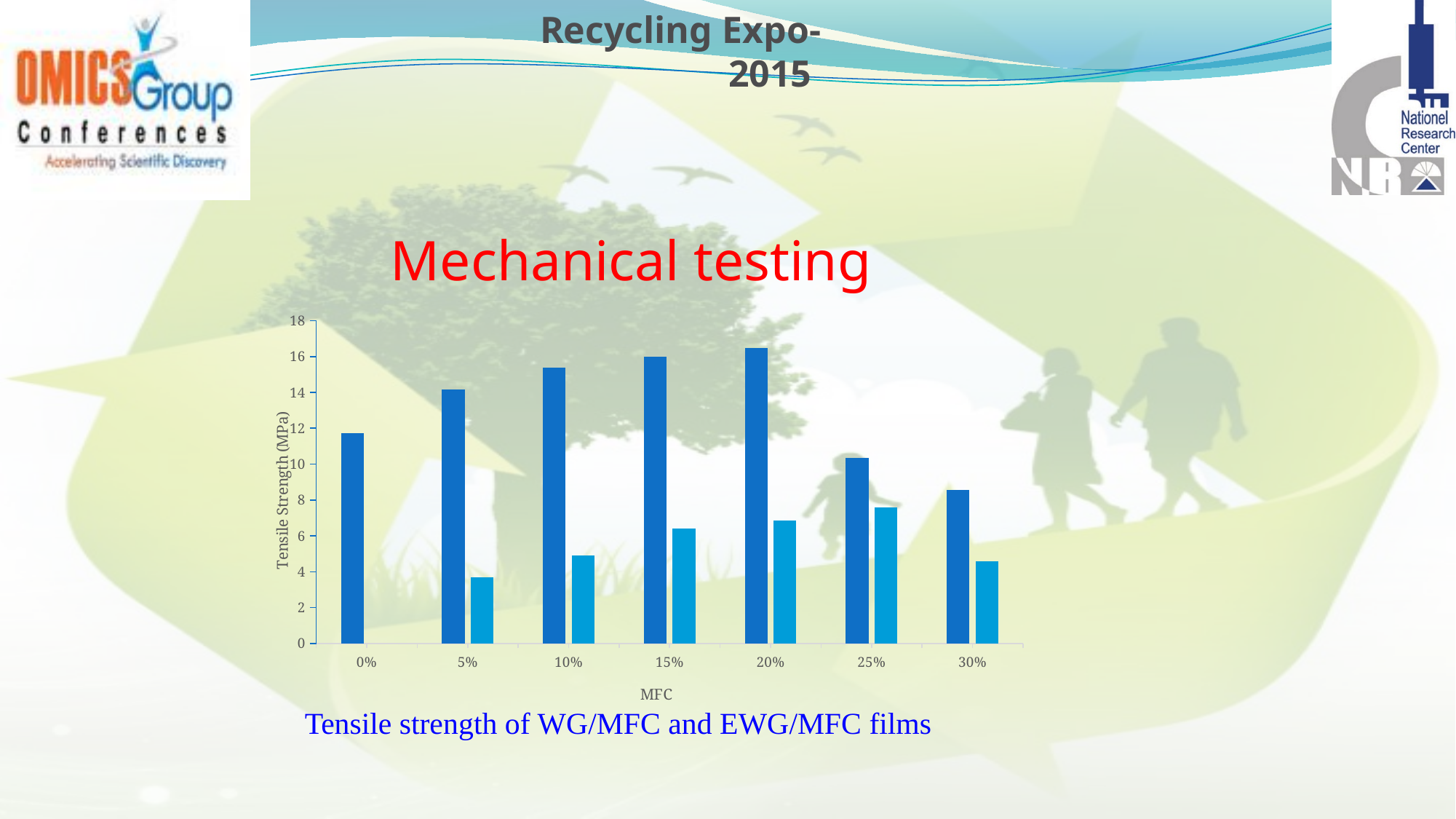
How many MFC categories are shown on the x axis of the chart? 7 Do the dark blue bars rise or fall from 0% MFC to 20% MFC? rise At which MFC level is the dark blue bar the lowest? 30% Is the light blue bar at 25% MFC greater or less than 6 MPa? greater What is the label on the y axis of the chart? Tensile Strength (MPa) At which MFC level is the light blue bar the highest? 25% Which has the taller dark blue bar, 10% MFC or 25% MFC? 10% Is the dark blue bar at 30% MFC greater or less than 10 MPa? less Is the dark blue bar at 0% MFC greater or less than 10 MPa? greater At which MFC level is the light blue bar the lowest? 5% What kind of chart is shown on the slide? bar chart